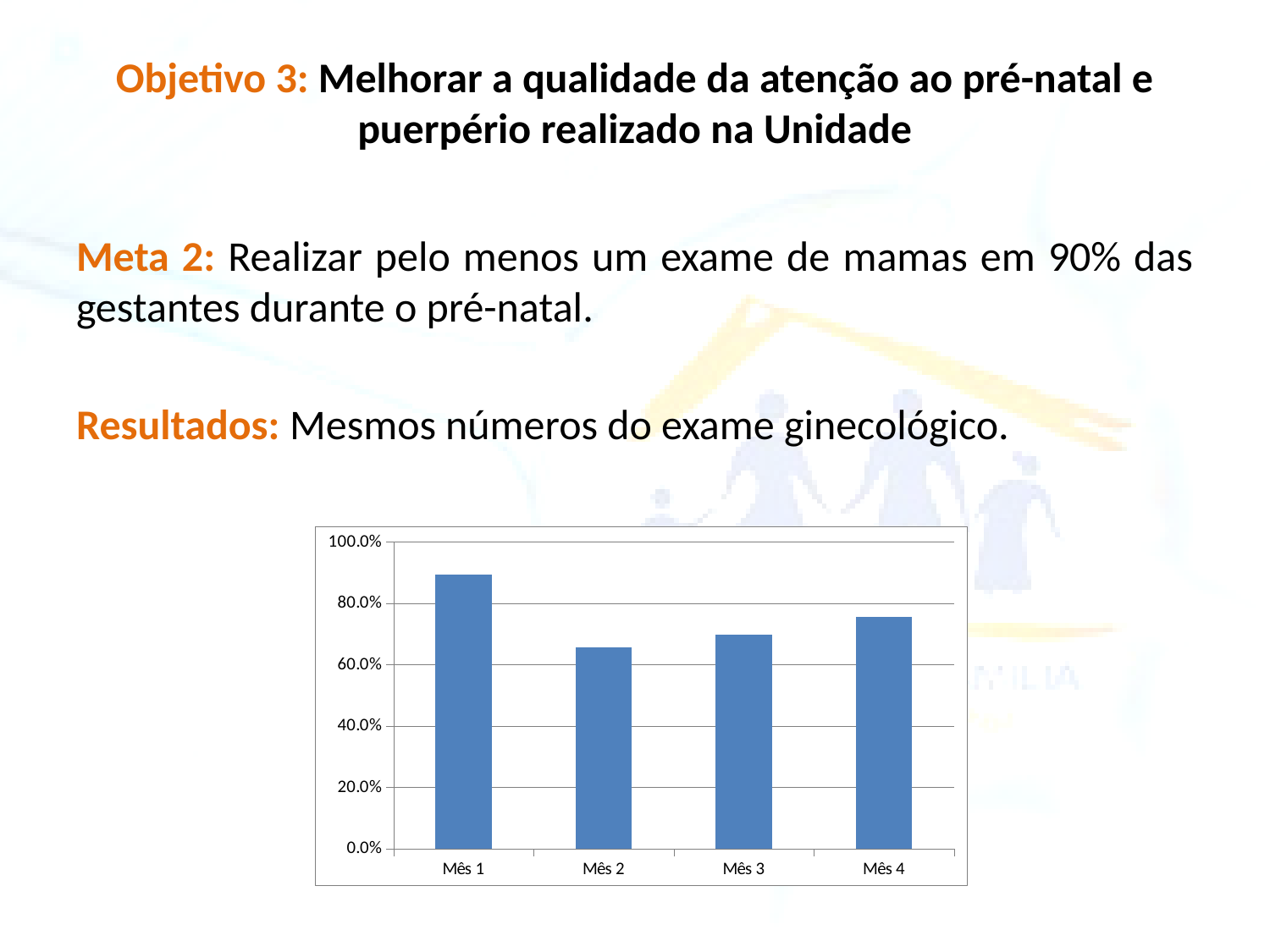
Which month has the lowest bar in the chart? Mês 2 Is the value for Mês 1 greater or less than 80.0%? greater Which is larger, the value for Mês 2 or the value for Mês 4? Mês 4 Is the value for Mês 2 greater or less than 80.0%? less What kind of chart is shown on the slide? bar chart How many categories are shown on the x axis of the chart? 4 Is the value for Mês 3 greater or less than 60.0%? greater Which is larger, the value for Mês 1 or the value for Mês 4? Mês 1 What is the highest tick label shown on the y axis of the chart? 100.0% Which month has the highest bar in the chart? Mês 1 Do the values rise or fall from Mês 2 to Mês 4? rise